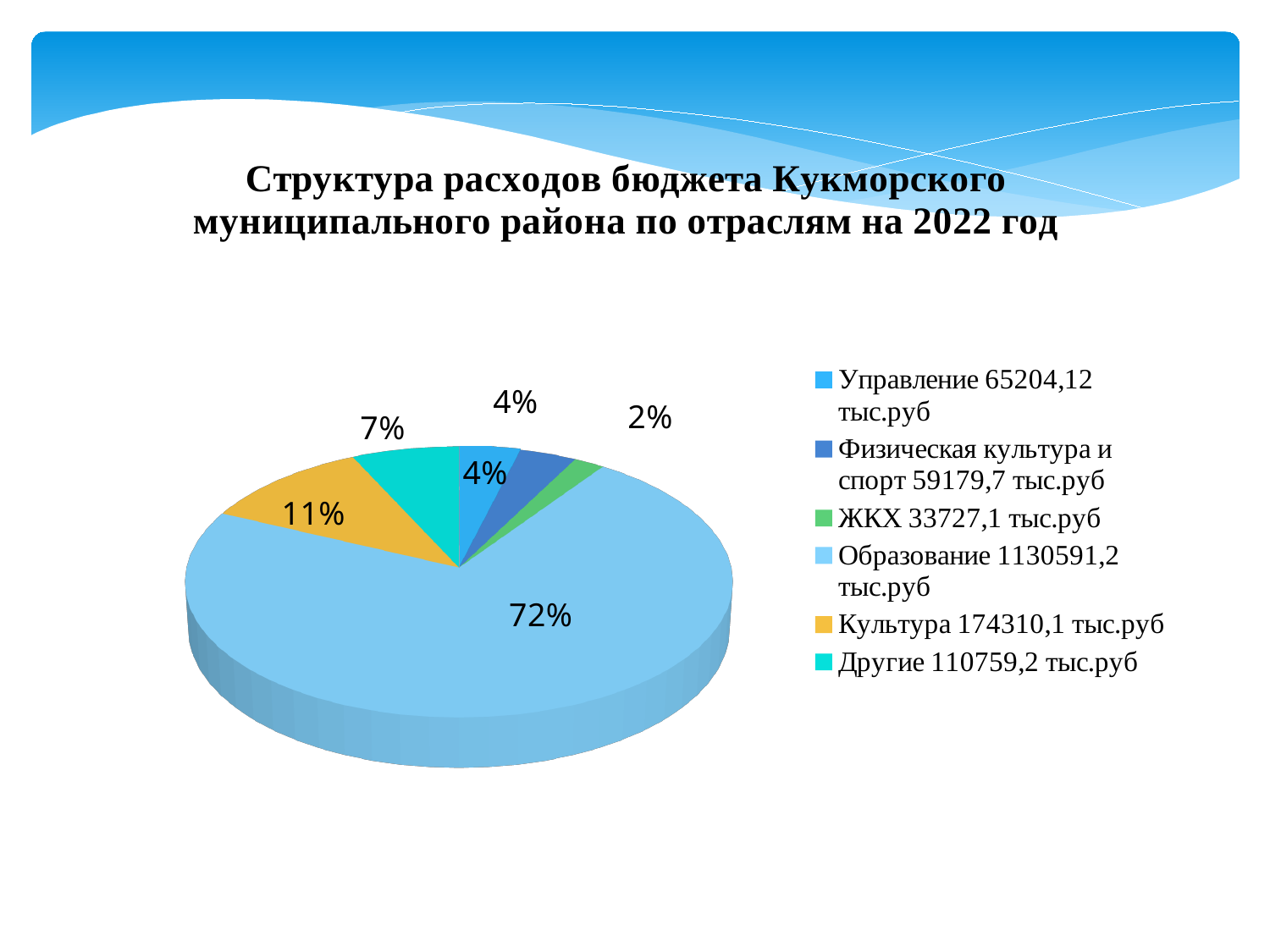
Which slice is larger, Культура or Другие? Культура How many categories does the pie chart show? 6 Which category has the largest slice of the pie? Образование What share of the pie does Образование take? 72% According to the legend, what amount is given for Культура? 174310,1 тыс.руб According to the legend, what amount is given for Образование? 1130591,2 тыс.руб What share of the pie does Другие take? 7% Which category has the smallest slice of the pie? ЖКХ What kind of chart is shown on the slide? pie chart What share of the pie does ЖКХ take? 2% What is the difference in percentage points between the Образование slice and the Культура slice? 61%